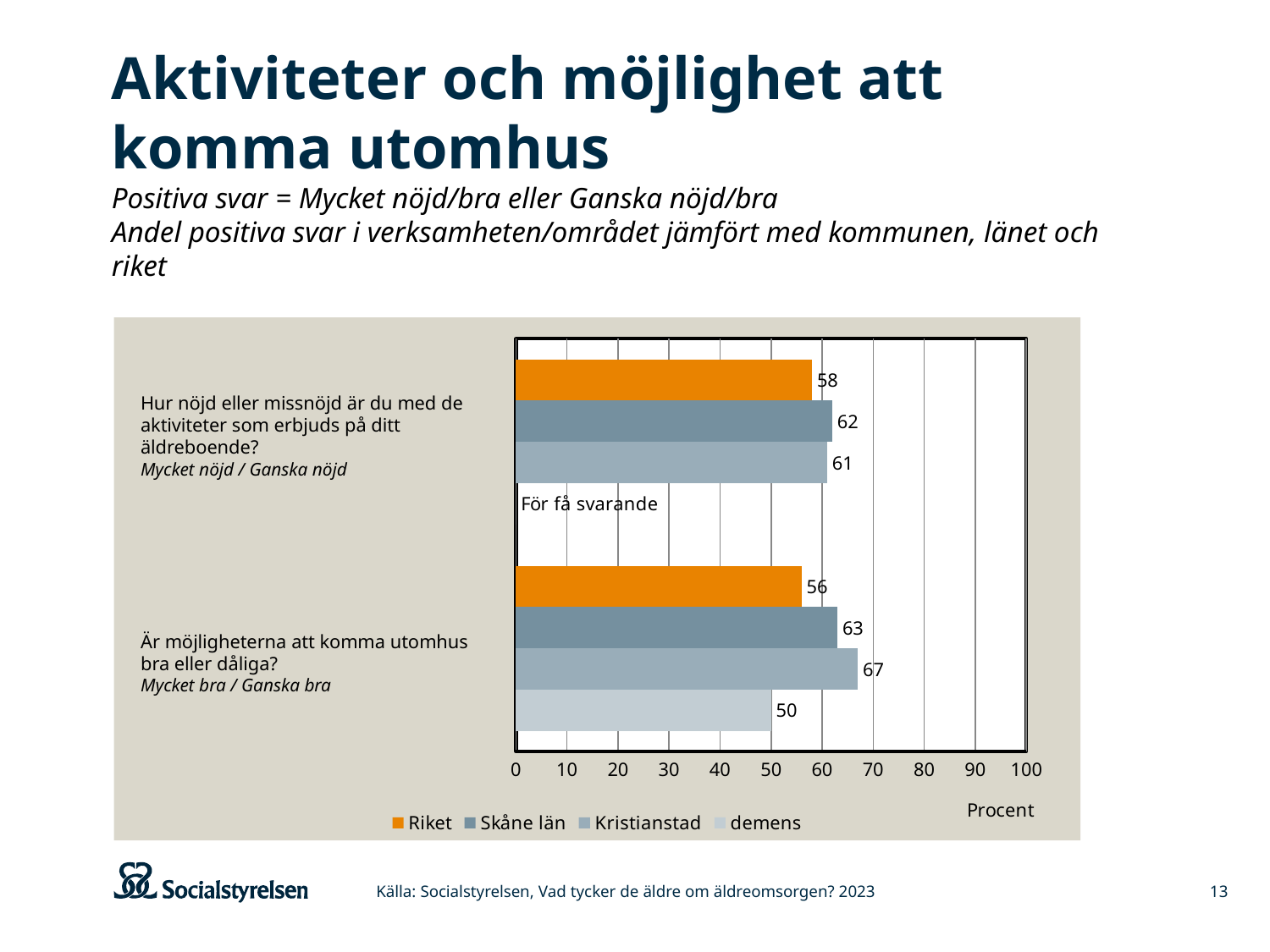
What value is shown for demens on the question about opportunities to get outdoors? 50 What kind of chart is shown on the slide? Bar chart Which is larger on the question about activities offered at the care home: Skåne län or Riket? Skåne län What unit is shown on the x axis of the chart? Procent What colour are the bars for the Riket series? Orange What is the difference between Kristianstad and demens on the question about opportunities to get outdoors? 17 What value is shown for Skåne län on the question about opportunities to get outdoors (Är möjligheterna att komma utomhus bra eller dåliga?)? 63 What value is shown for Riket on the question about activities offered at the care home (Hur nöjd eller missnöjd är du med de aktiviteter som erbjuds på ditt äldreboende?)? 58 Which series has the highest value on the question about opportunities to get outdoors? Kristianstad What is shown for the demens series on the question about activities offered at the care home? För få svarande Which series has the lowest value on the question about opportunities to get outdoors? demens How many series does the legend list? 4